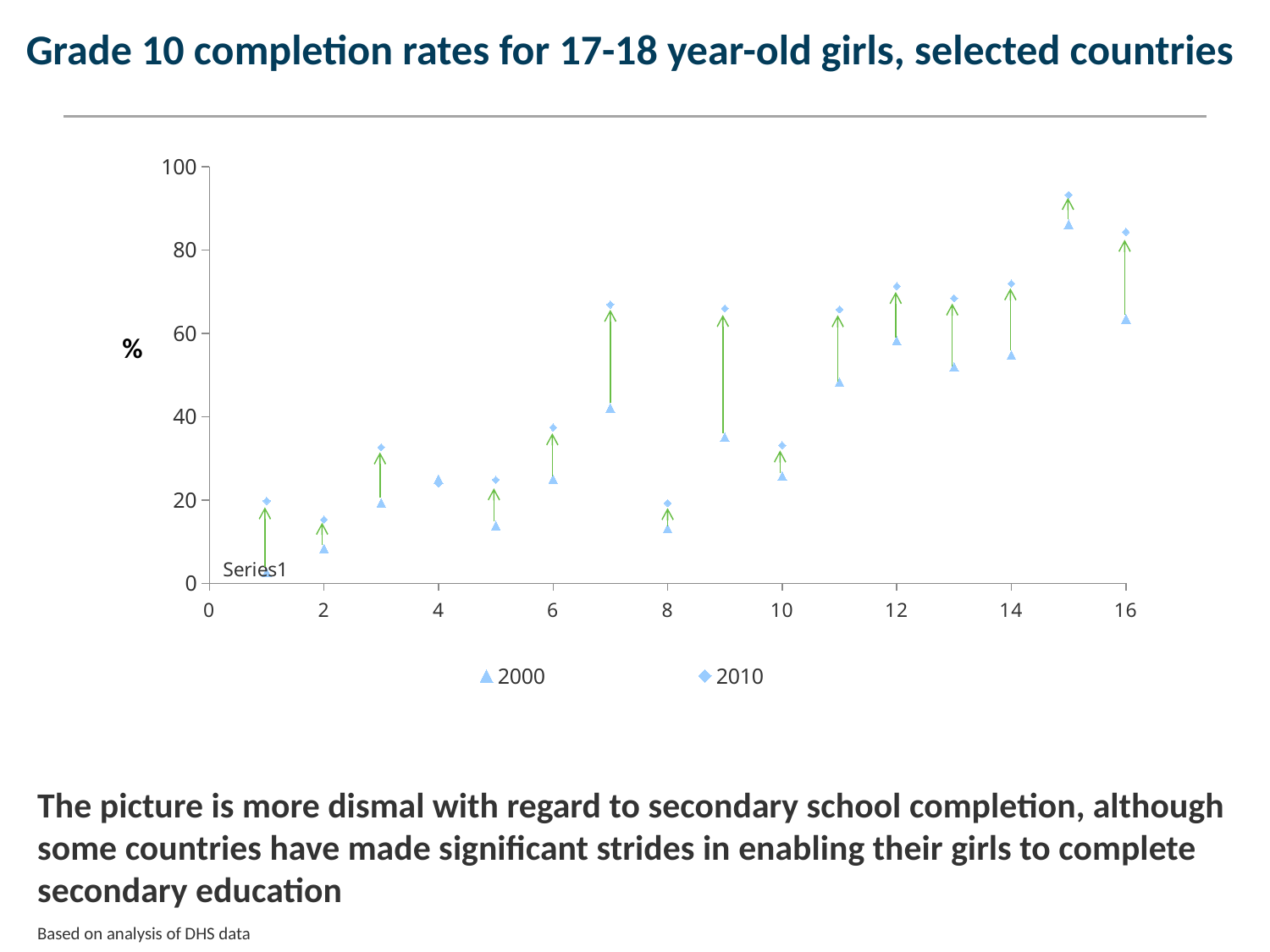
What is the title of the chart? Grade 10 completion rates for 17-18 year-old girls, selected countries How many countries (x-axis points) are plotted for each series? 16 Is the 2000 value at x = 9 greater or less than 40? less At which x-axis position is the 2010 value highest? 15 Is the 2000 value at x = 15 greater or less than 80? greater Is the 2010 value at x = 7 greater or less than 60? greater At x = 7, which series has the larger value, 2000 or 2010? 2010 At which x-axis position is the 2000 value lowest? 1 What are the two series named in the legend? 2000 and 2010 What kind of chart is shown on the slide? scatter chart How many series does the legend list? 2